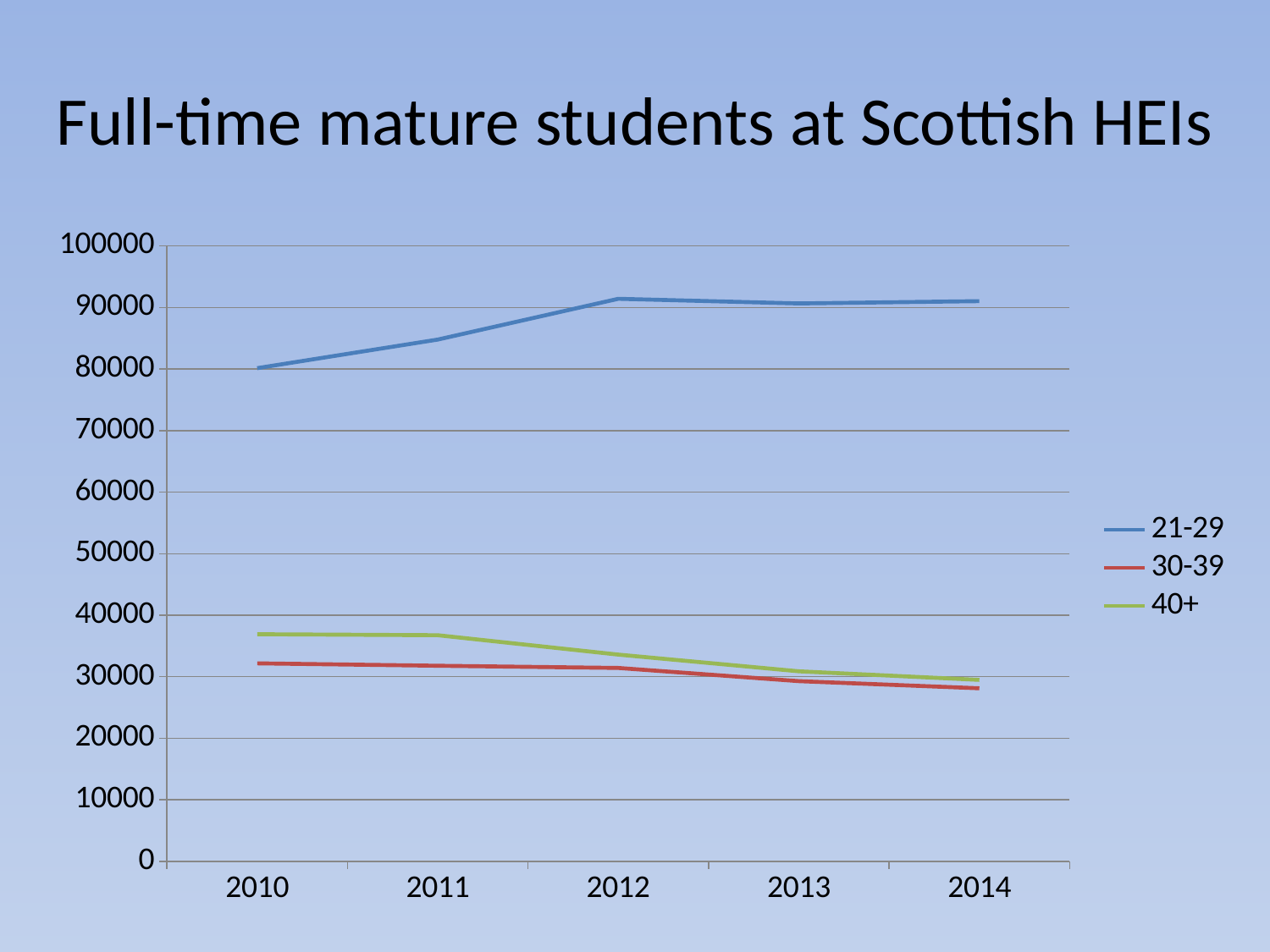
What is the title of the chart? Full-time mature students at Scottish HEIs In 2010, which is larger: the value for 40+ or the value for 30-39? 40+ Which age group has the highest values across all years? 21-29 Which series are listed in the legend? 21-29, 30-39, 40+ Is the value for 40+ in 2010 greater or less than 40000? less Is the value for 30-39 in 2014 greater or less than 30000? less How many series does the legend list? 3 What kind of chart is shown on the slide? Line chart Which age group has the lowest value in 2010? 30-39 Does the 40+ series rise or fall from 2010 to 2014? Fall How many years are plotted along the x axis? 5 Is the value for 21-29 in 2011 greater or less than 80000? greater